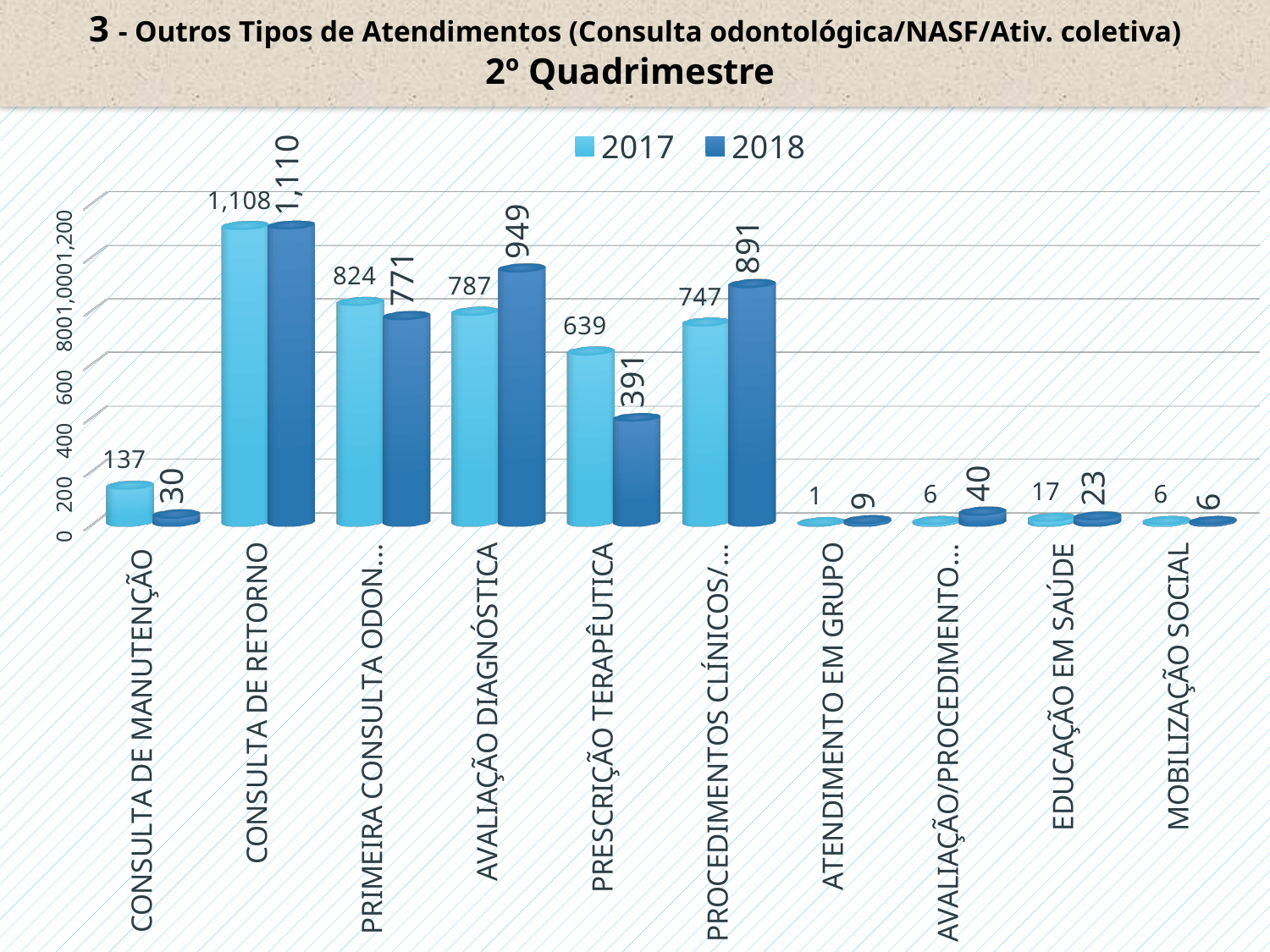
How many categories are shown on the x axis? 10 Which category has the lowest 2017 value? ATENDIMENTO EM GRUPO What is the 2018 value for AVALIAÇÃO DIAGNÓSTICA? 949 What is the 2017 value for EDUCAÇÃO EM SAÚDE? 17 What kind of chart is shown on the slide? Bar chart For CONSULTA DE MANUTENÇÃO, which year has the larger value, 2017 or 2018? 2017 How many series does the legend list? 2 What is the difference between the 2018 and 2017 values for AVALIAÇÃO DIAGNÓSTICA? 162 What is the 2017 value for CONSULTA DE MANUTENÇÃO? 137 What is the difference between the 2017 and 2018 values for PRESCRIÇÃO TERAPÊUTICA? 248 What is the 2018 value for PRESCRIÇÃO TERAPÊUTICA? 391 Which category has the highest 2018 value? CONSULTA DE RETORNO